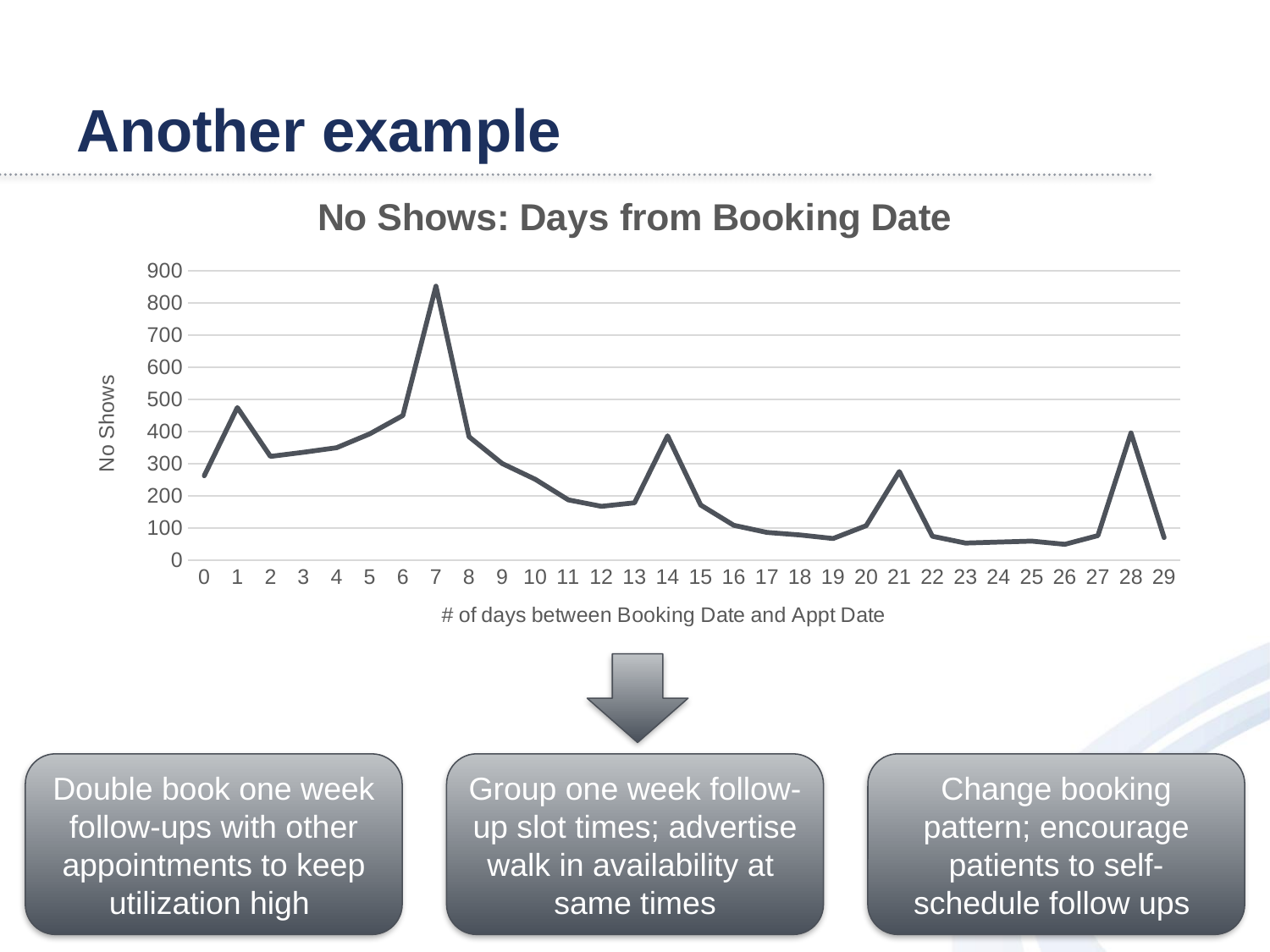
How many data points are plotted on the line? 30 What is the title of the chart? No Shows: Days from Booking Date Is the number of no shows at 7 days greater or less than 700? greater At which number of days between booking date and appointment date is the number of no shows highest? 7 Is the number of no shows at 29 days greater or less than 100? less Do the no shows rise or fall from 7 days to 13 days? fall Which has more no shows: 7 days or 14 days? 7 days What is the label of the x axis? # of days between Booking Date and Appt Date Is the number of no shows at 1 day greater or less than 400? greater What kind of chart is shown on the slide? line chart